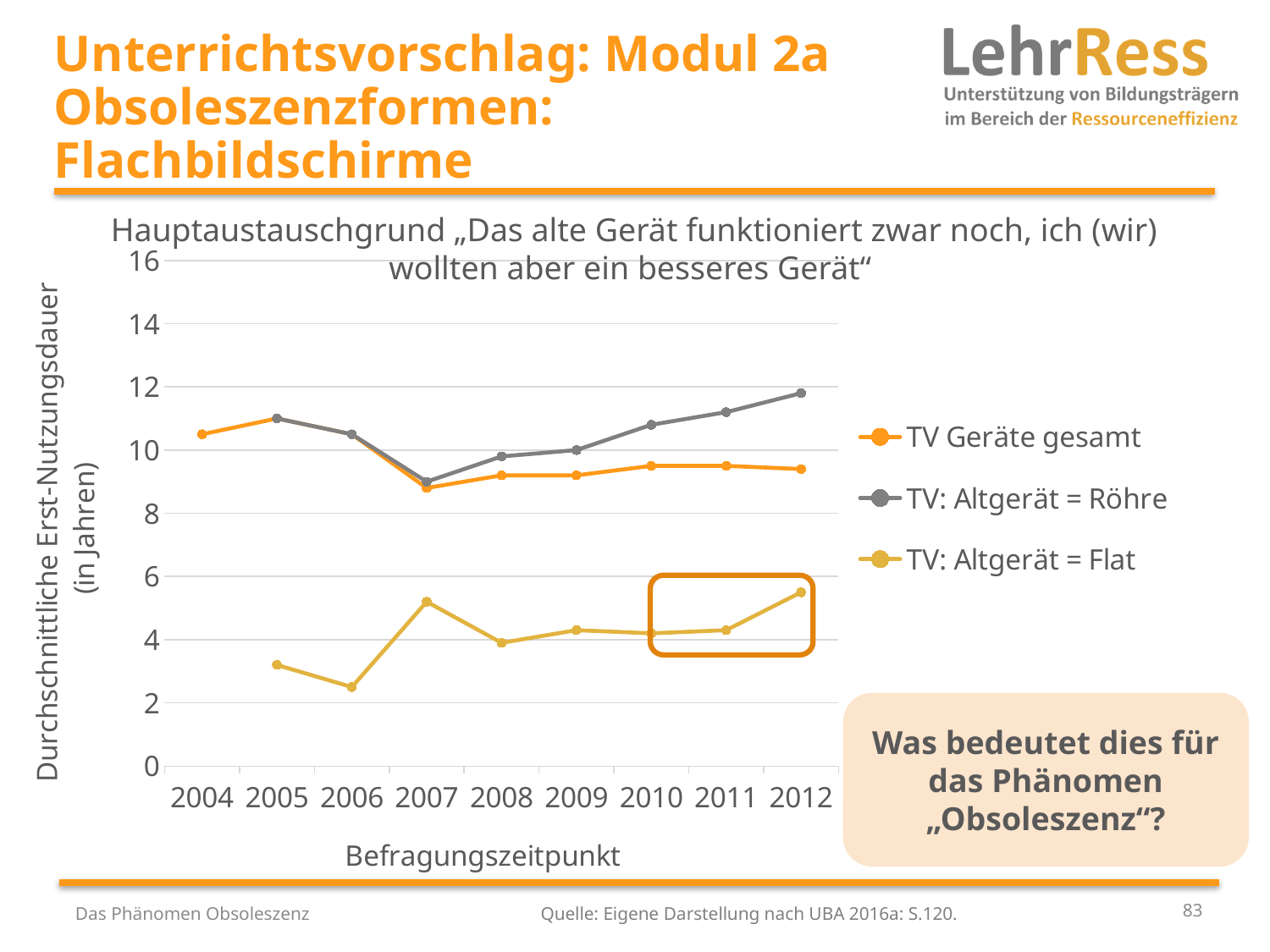
What kind of chart is shown on the slide? line chart Is the value for "TV: Altgerät = Röhre" in 2012 greater or less than 10? greater Is the value for "TV Geräte gesamt" in 2007 greater or less than 10? less Is the value for "TV: Altgerät = Flat" in 2007 greater or less than 4? greater In which year does the "TV: Altgerät = Röhre" series reach its highest value? 2012 In which year does the "TV: Altgerät = Flat" series have its lowest value? 2006 Does the "TV: Altgerät = Röhre" series rise or fall from 2007 to 2012? rise What is the label of the x axis of the chart? Befragungszeitpunkt How many survey years are shown on the x axis? 9 In 2012, which series has the larger value: "TV: Altgerät = Röhre" or "TV: Altgerät = Flat"? TV: Altgerät = Röhre How many series does the chart legend list? 3